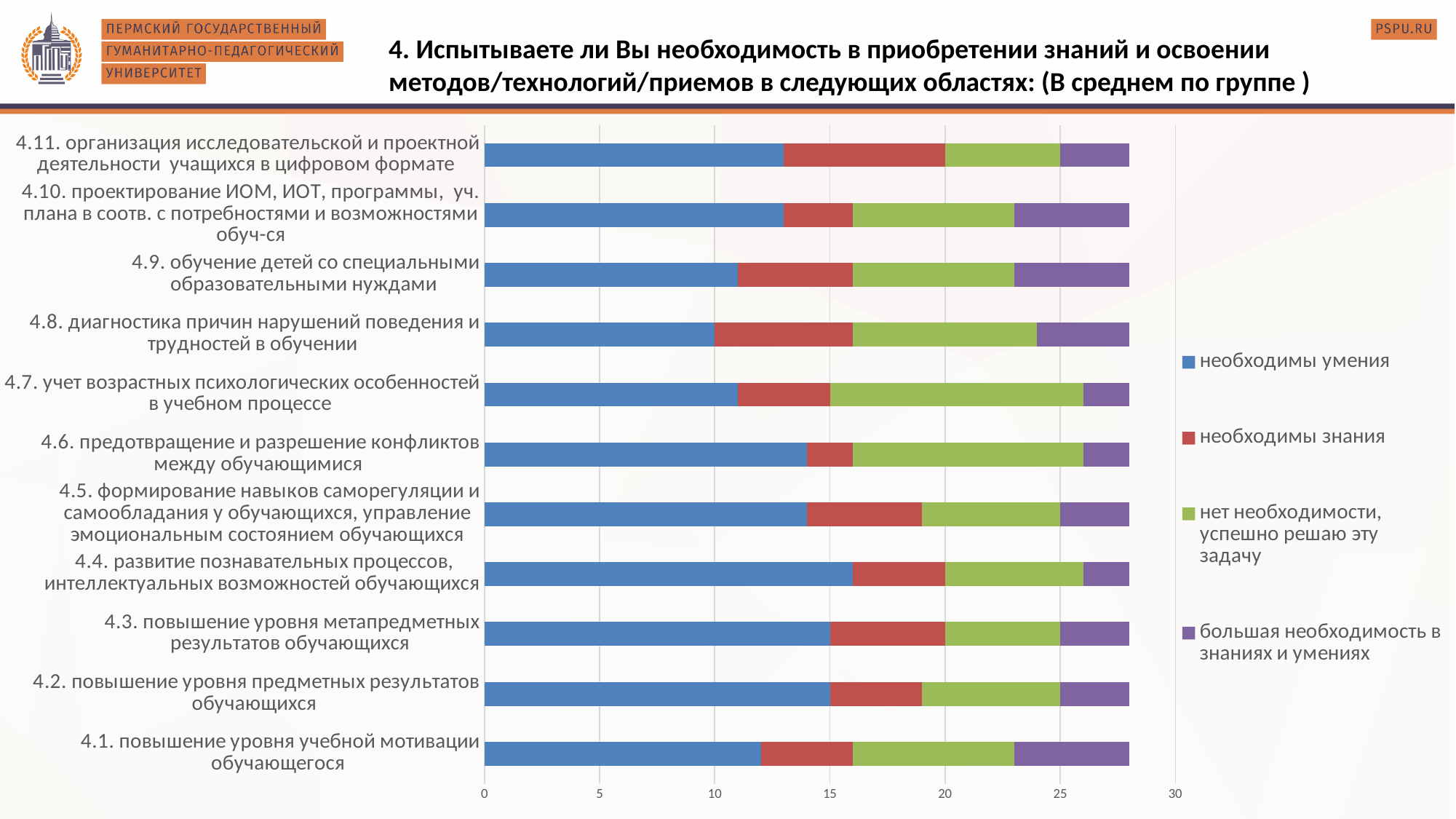
Is the value of 'необходимы умения' for category 4.8 greater or less than 15? less Which is larger: the 'необходимы умения' value for category 4.4 or for category 4.8? 4.4 What kind of chart is shown on the slide? bar chart Is the value of 'необходимы умения' for category 4.1 greater or less than 10? greater Which series is shown in blue in the legend? необходимы умения Is the value of 'необходимы умения' for category 4.6 greater or less than 15? less Which is larger: the 'необходимы умения' value for category 4.1 or for category 4.3? 4.3 How many series does the legend list? 4 Which series is shown in purple in the legend? большая необходимость в знаниях и умениях How many categories (areas 4.1–4.11) are plotted on the chart? 11